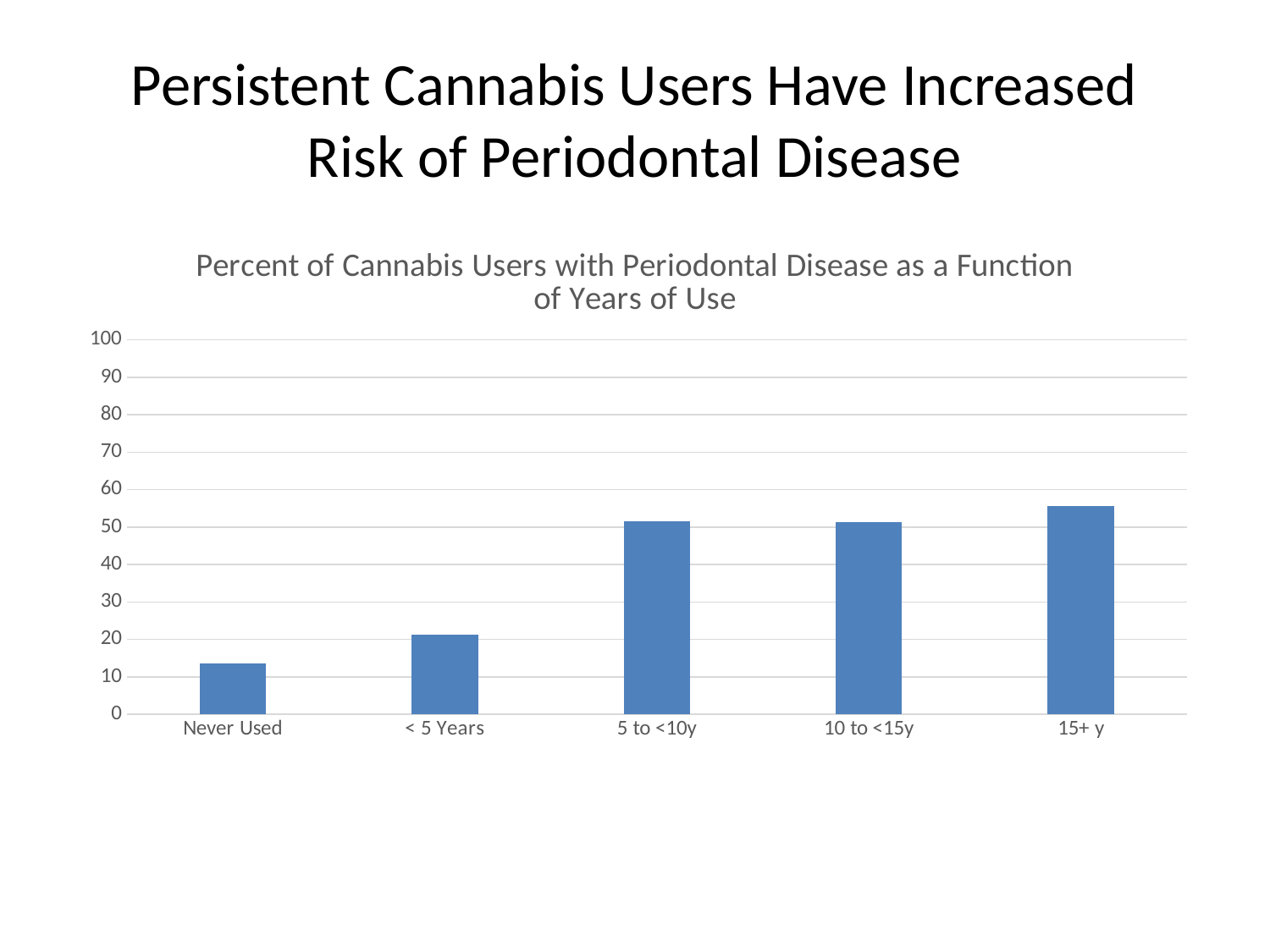
What kind of chart is shown on the slide? bar chart Which is larger, the value for Never Used or the value for < 5 Years? < 5 Years Which category has the highest percent of users with periodontal disease? 15+ y Is the value for 5 to <10y greater or less than 40? greater Is the value for 15+ y greater or less than 50? greater Is the value for < 5 Years greater or less than 30? less Do the values generally rise or fall as years of use increase along the x axis? rise How many categories of years of use are shown on the x axis? 5 Which category has the lowest percent of users with periodontal disease? Never Used What is the title of the chart? Percent of Cannabis Users with Periodontal Disease as a Function of Years of Use